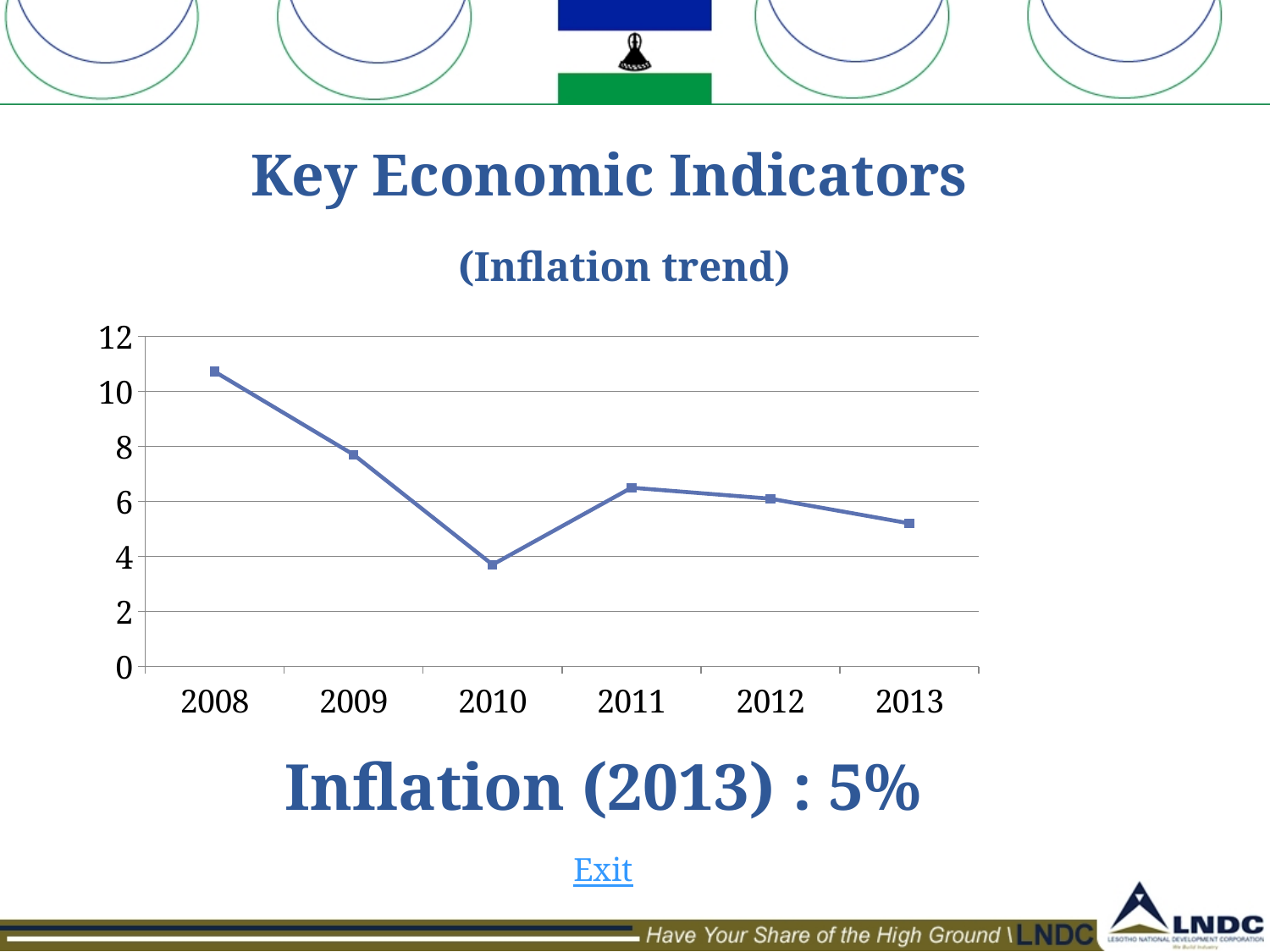
What kind of chart is shown on the slide? line chart Which year has the lowest inflation value in the chart? 2010 Is the value for 2013 greater or less than 6? less Is the value for 2009 greater or less than 8? less Which year has the larger value, 2009 or 2011? 2009 Is the value for 2010 greater or less than 4? less Which year has the highest inflation value in the chart? 2008 Does the line rise or fall between 2010 and 2011? rise How many years are plotted on the x axis of the chart? 6 Which year has the larger value, 2010 or 2013? 2013 What is the subtitle shown above the chart in parentheses? (Inflation trend)